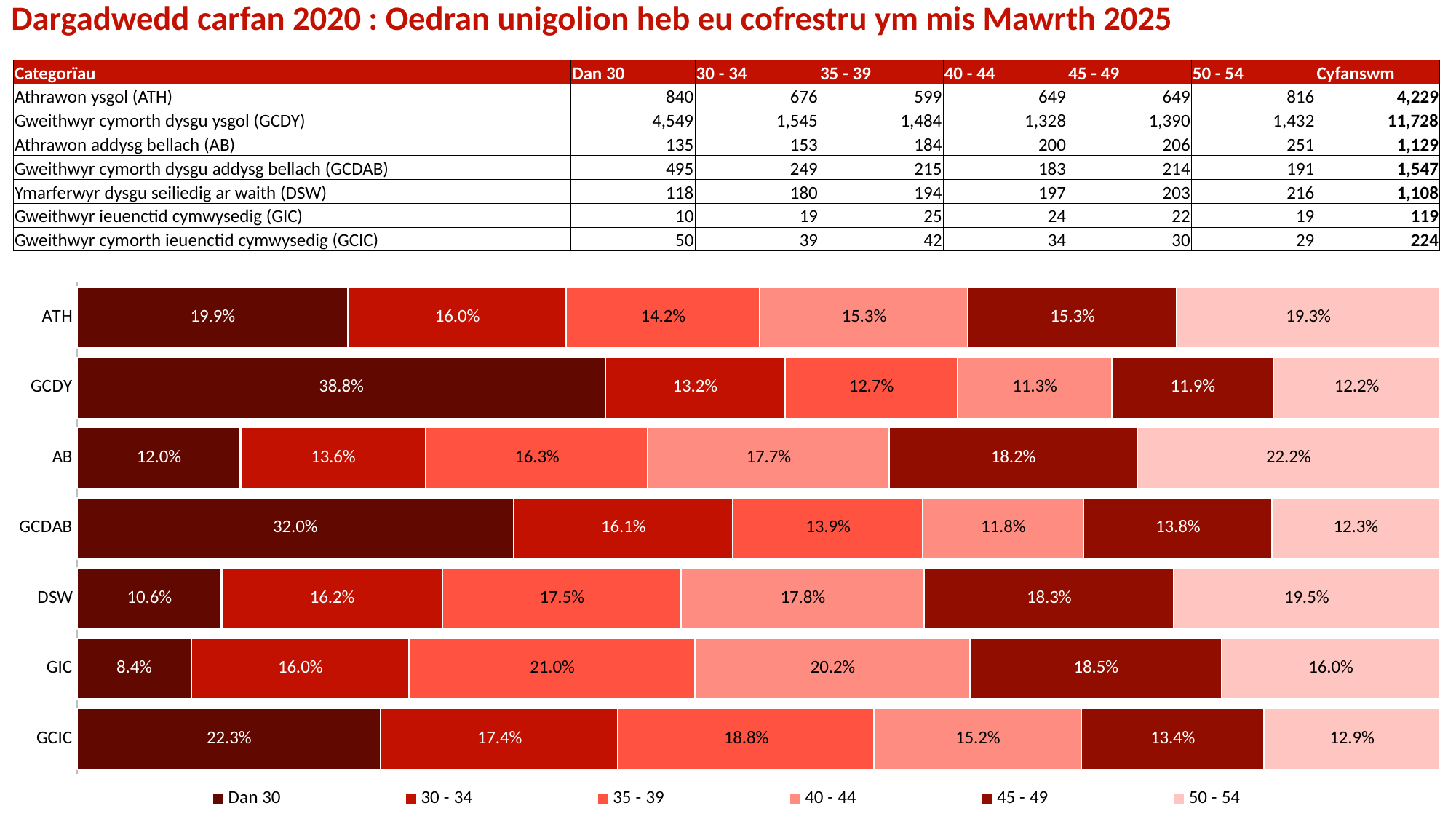
How many series does the chart legend list? 6 What is the value for the 35 - 39 segment of the GIC bar? 21.0% What is the first entry in the chart legend? Dan 30 What is the value for the 50 - 54 segment of the AB bar? 22.2% Which is larger: the 50 - 54 value for DSW or the 50 - 54 value for GCIC? DSW What is the difference between the Dan 30 and 35 - 39 values in the ATH bar? 5.7 percentage points Within the AB bar, which age group has the largest share? 50 - 54 What kind of chart is shown on the slide? Stacked bar chart Which category has the largest Dan 30 share? GCDY What is the value for the Dan 30 segment of the GCDY bar? 38.8% How many categories are shown on the chart's vertical axis? 7 Which category has the smallest Dan 30 share? GIC